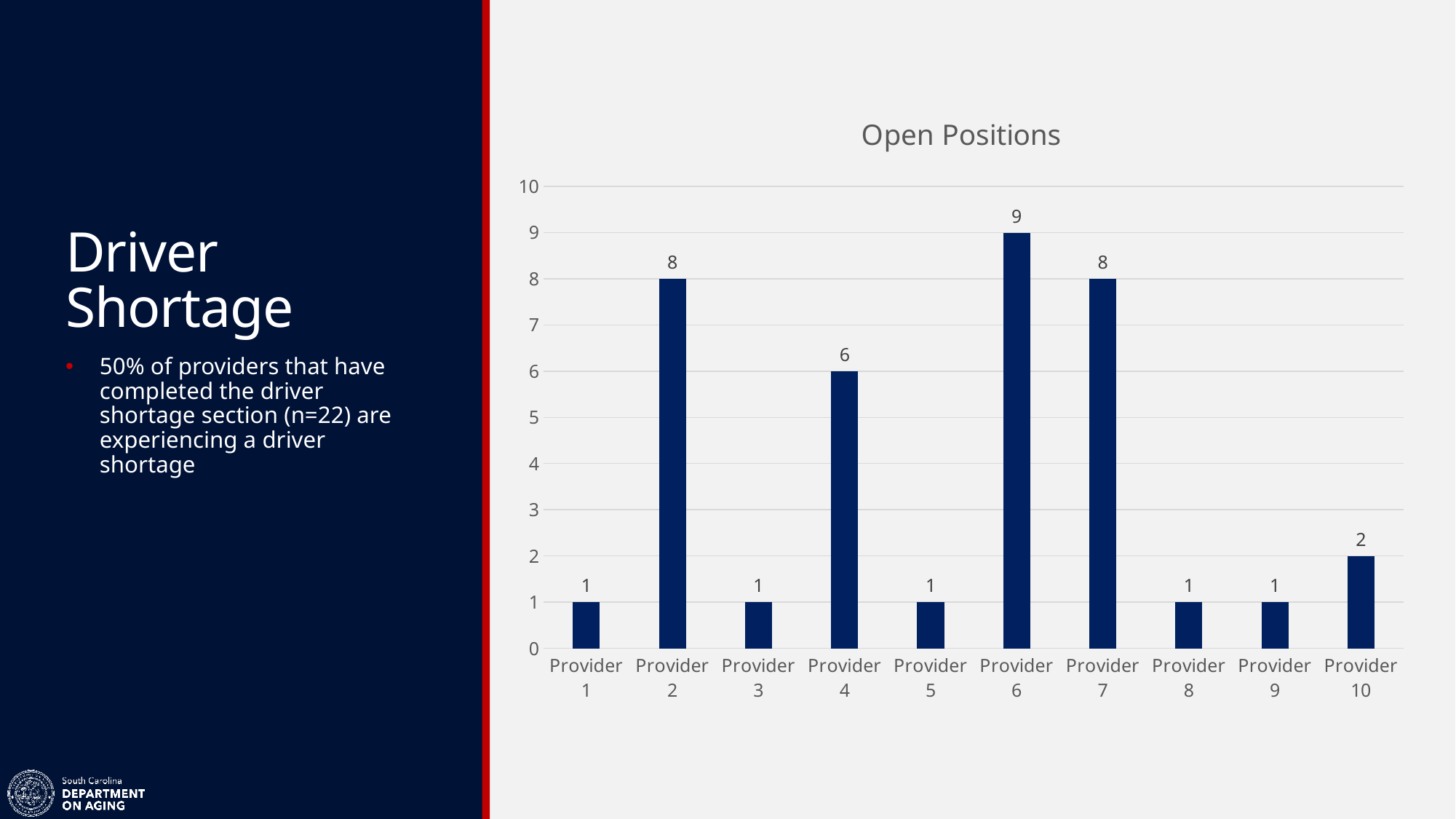
What is the title of the chart? Open Positions Is the value for Provider 2 greater or less than 5? greater How many providers have exactly 1 open position? 5 How many open positions does Provider 4 have? 6 What is the difference between the values for Provider 2 and Provider 10? 6 How many providers are shown on the x axis of the chart? 10 What is the value shown for Provider 10? 2 Which provider has the highest number of open positions? Provider 6 Which is larger, the value for Provider 4 or the value for Provider 7? Provider 7 What is the value for Provider 6 in the Open Positions chart? 9 What is the difference between the values for Provider 6 and Provider 4? 3 What kind of chart is shown on the slide? Bar chart